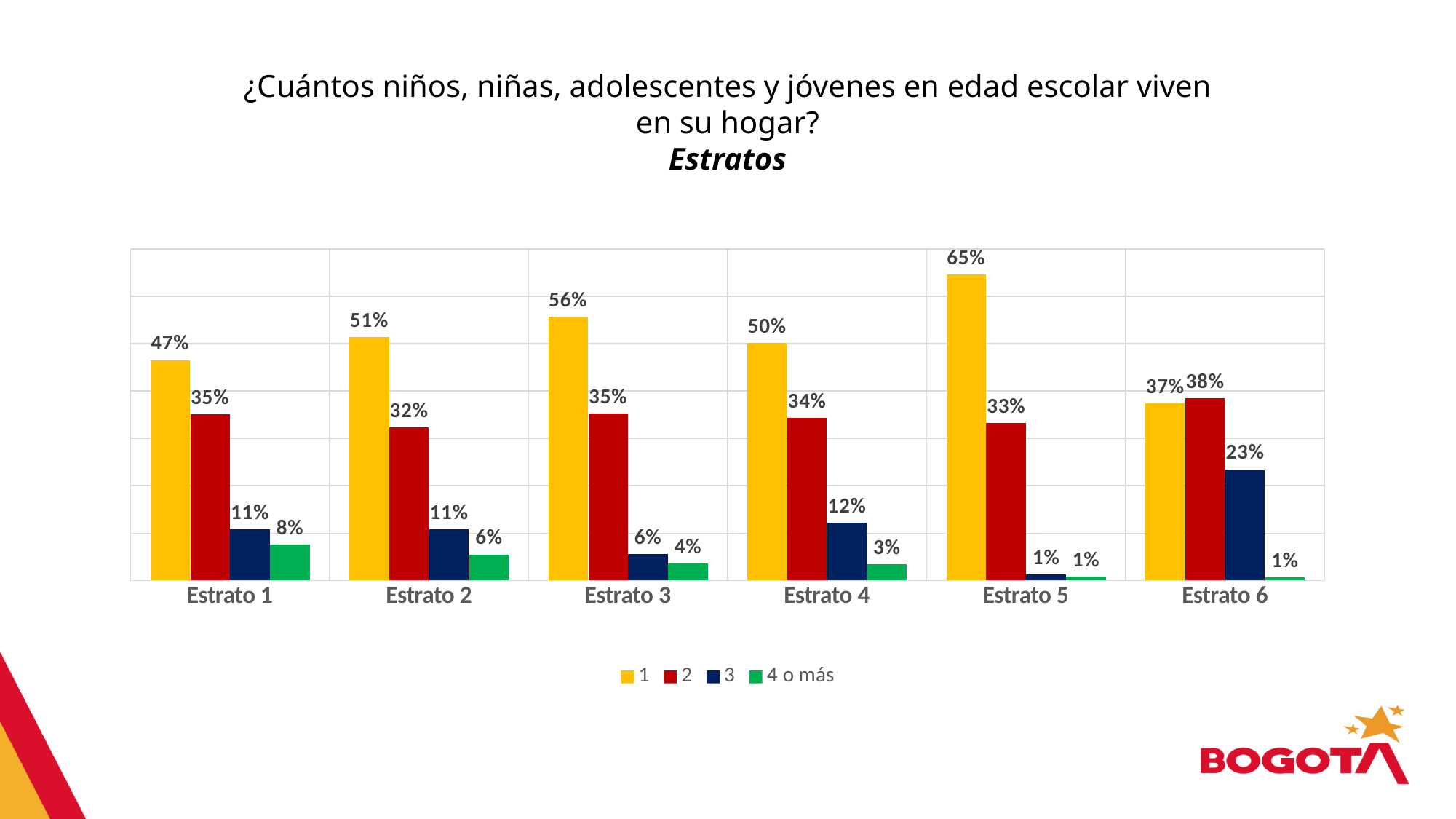
What is the value for series "2" in Estrato 2? 32% What colour represents series "4 o más" in the chart? Green Which estrato has the highest value for series "1"? Estrato 5 Which estrato has the lowest value for series "1"? Estrato 6 Which is larger in Estrato 6: the value for series "1" or series "2"? 2 How many estrato categories are shown on the x axis? 6 What is the value for series "3" in Estrato 6? 23% What kind of chart is shown on the slide? Bar chart How many series does the legend list? 4 What is the value for series "4 o más" in Estrato 1? 8% What is the difference between the values for series "1" and series "2" in Estrato 3? 21% What is the value for series "1" in Estrato 5? 65%